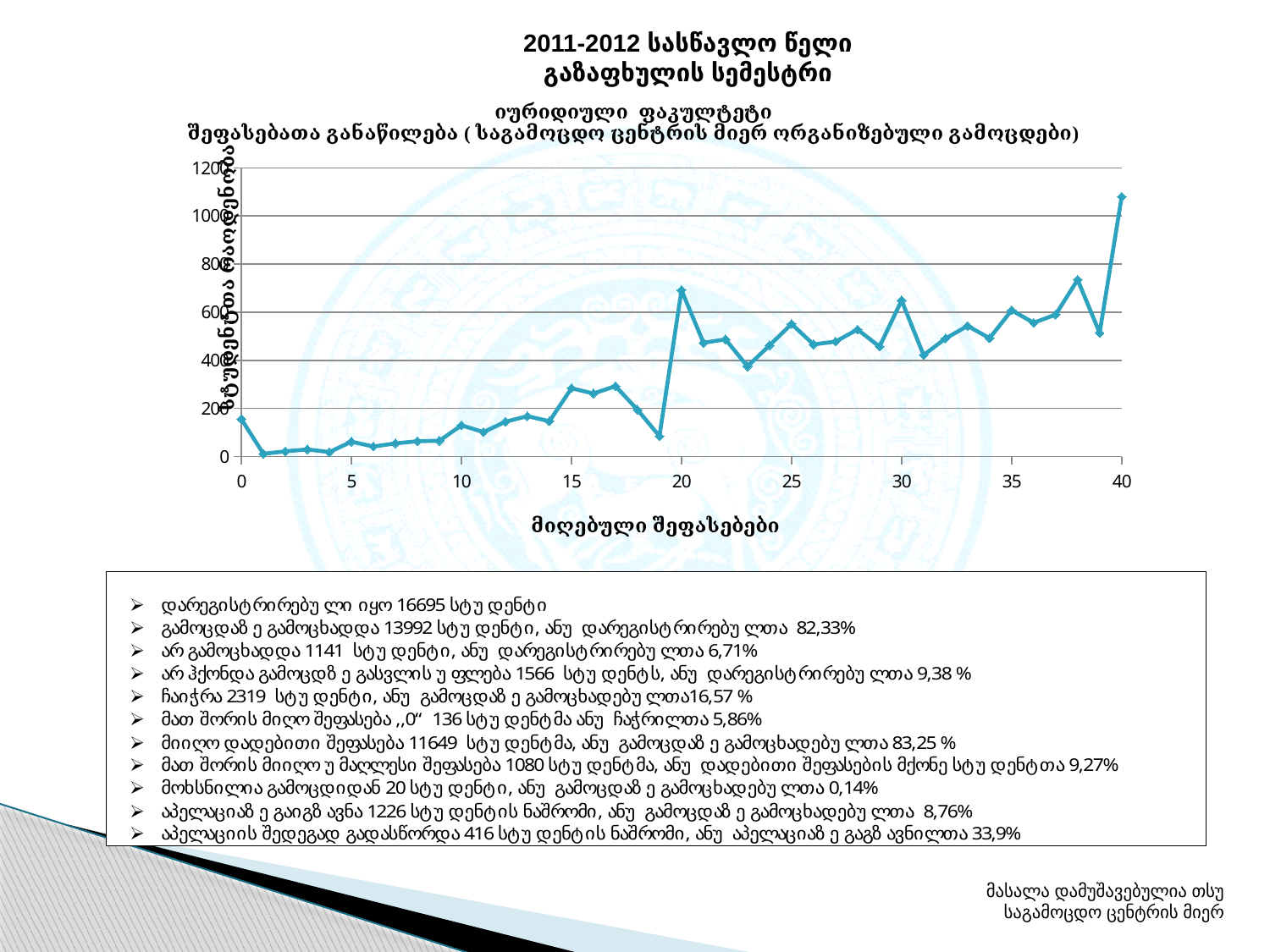
Is the value at x = 40 greater or less than 1000? greater Is the value at x = 20 greater or less than 600? greater Is the value at x = 19 greater or less than 200? less Which is larger, the value at x = 19 or the value at x = 20? x = 20 Overall, do the values rise or fall as the score on the x axis increases? rise What is the title of the x axis of the chart? მიღებული შეფასებები What kind of chart is shown on the slide? line chart Which is larger, the value at x = 38 or the value at x = 39? x = 38 At which score on the x axis does the line reach its highest value? 40